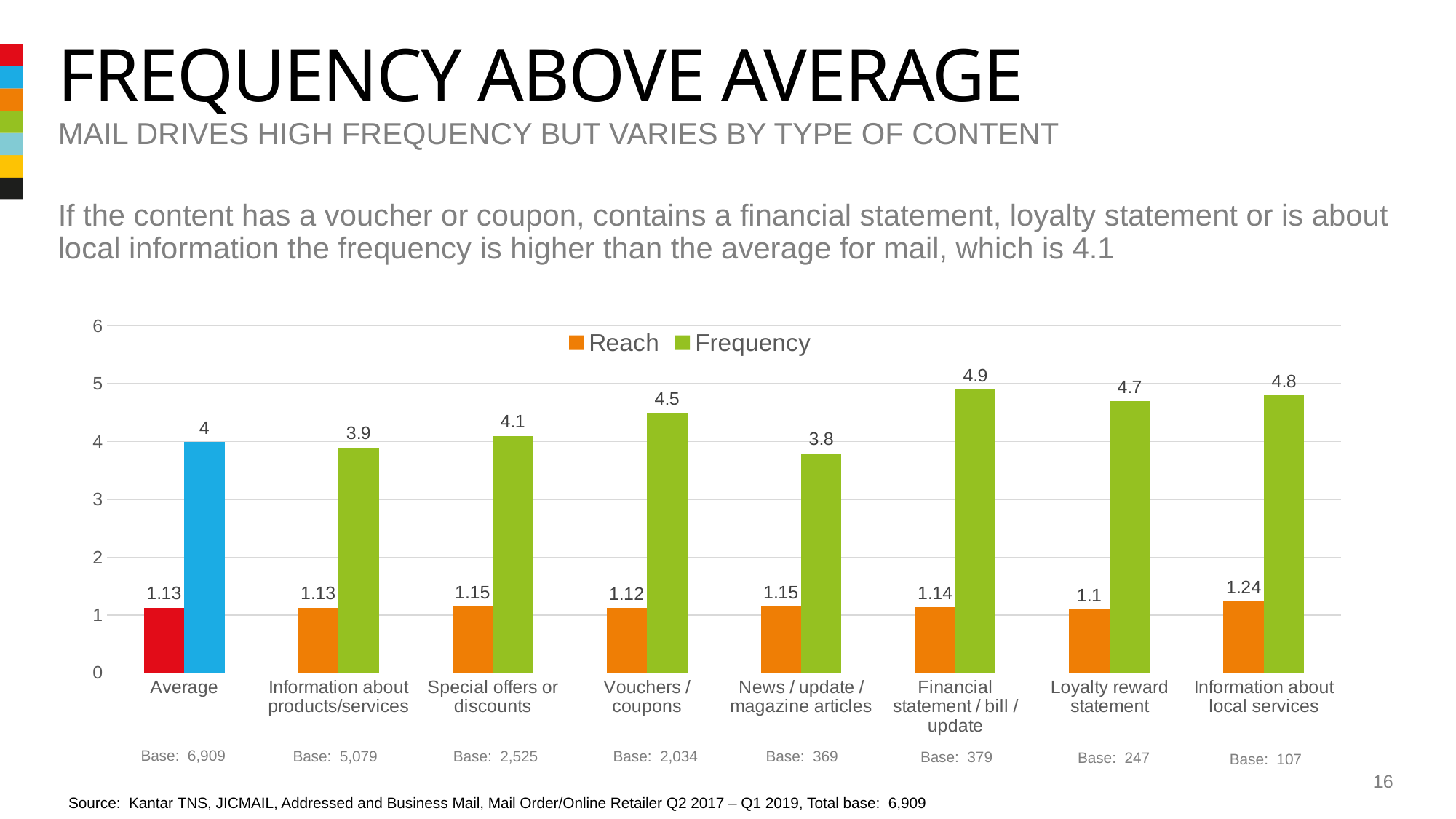
What is the Frequency value for the Average category? 4 What are the two series named in the chart legend? Reach and Frequency Which has a higher Frequency value, Loyalty reward statement or Information about local services? Information about local services What is the Frequency value for Vouchers / coupons? 4.5 Which category has the highest Frequency value? Financial statement / bill / update What is the difference between the Frequency values for Financial statement / bill / update and Information about products/services? 1 What is the Reach value for Information about local services? 1.24 What is the Reach value for Loyalty reward statement? 1.1 How many categories are shown on the x axis of the chart? 8 How many series does the chart legend list? 2 Which category has the lowest Frequency value? News / update / magazine articles What type of chart is shown on the slide? Bar chart